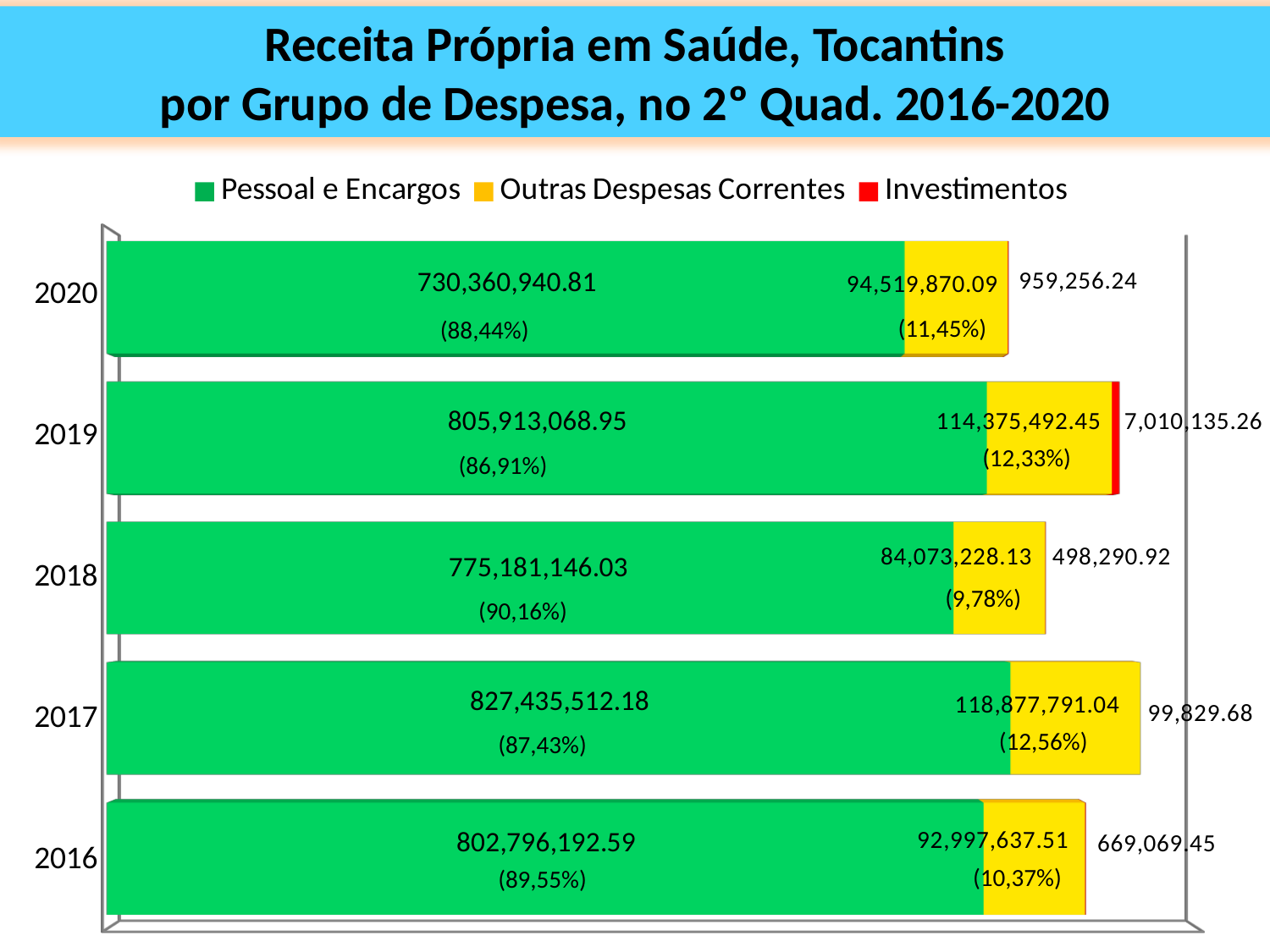
What is the total of the stacked bar for 2020? 825,840,067.14 What percentage share is shown for Pessoal e Encargos in 2018? 90,16% What is the difference between Pessoal e Encargos in 2017 and in 2020? 97,074,571.37 What is the value of Pessoal e Encargos for 2020? 730,360,940.81 Which year has the larger value for Outras Despesas Correntes, 2020 or 2016? 2020 What is the value of Outras Despesas Correntes for 2019? 114,375,492.45 In which year is Outras Despesas Correntes lowest? 2018 How many series does the legend list? 3 What is the value of Investimentos for 2019? 7,010,135.26 How many years are shown on the chart? 5 What kind of chart is shown on the slide? Stacked bar chart In which year is Pessoal e Encargos highest? 2017